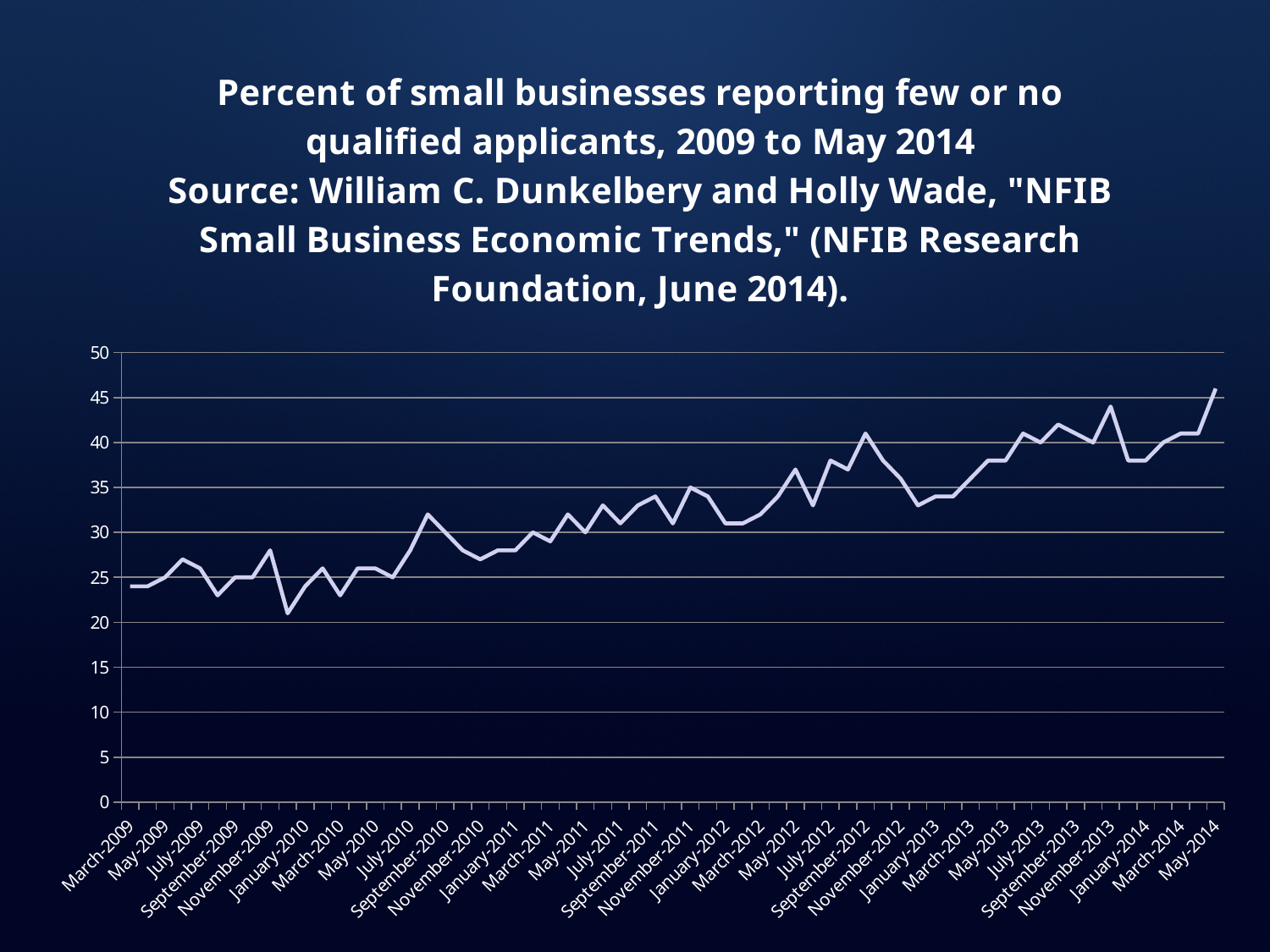
Which is larger, the value for January-2010 or the value for September-2012? September-2012 Which month has the highest value on the chart? May-2014 What kind of chart is shown on the slide? line chart Is the value for May-2014 greater or less than 40? greater Is the value for September-2012 greater or less than 35? greater Overall, do the values rise or fall from March-2009 to May-2014? rise Which is larger, the value for May-2014 or the value for March-2009? May-2014 Is the value for March-2009 greater or less than 30? less What is the highest value shown on the vertical axis? 50 Which month has the lowest value on the chart? December-2009